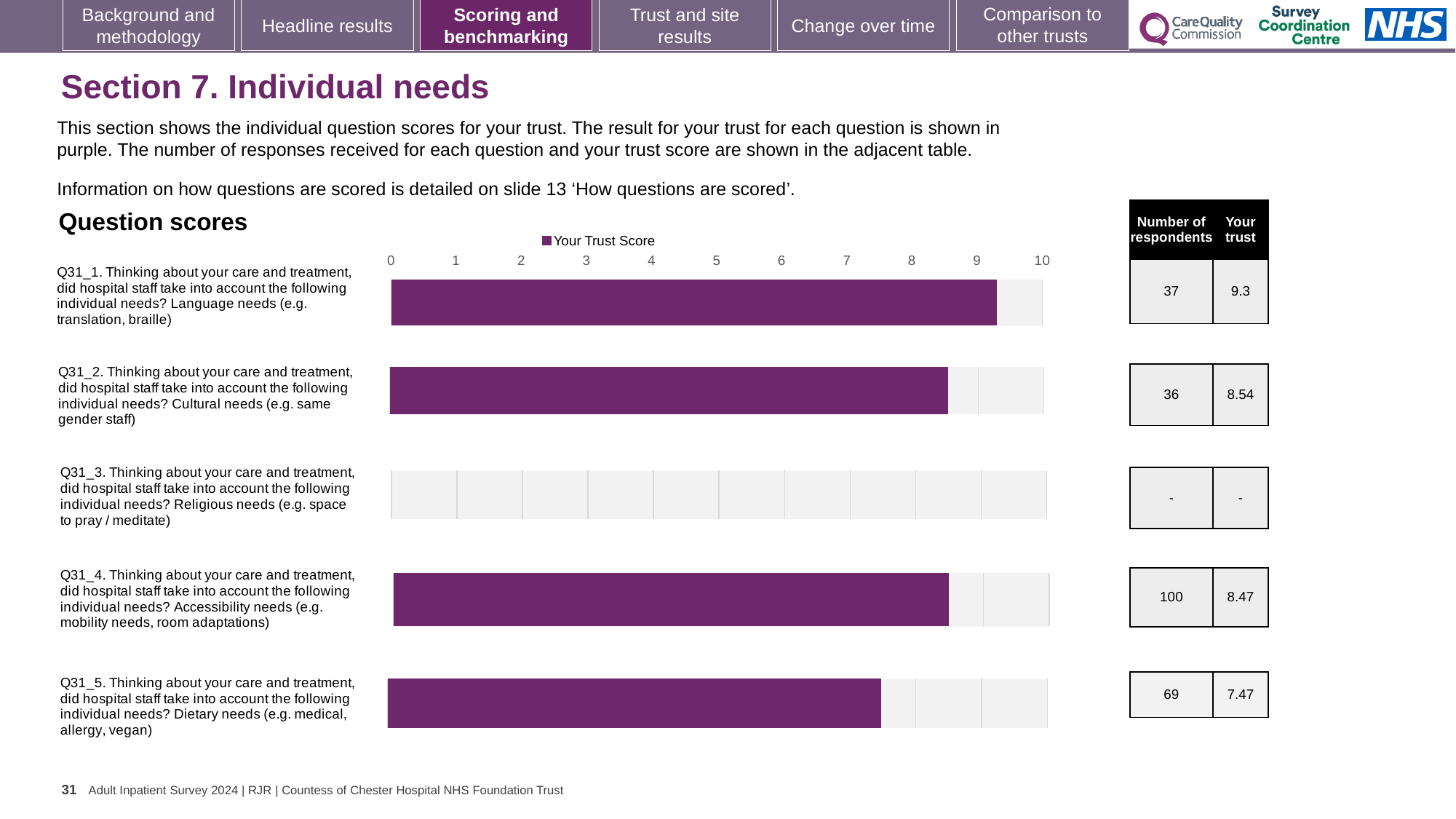
How many respondents answered Q31_4 (Accessibility needs)? 100 How many questions are listed in the Question scores chart? 5 What kind of chart is used to show the question scores? bar chart Which has the larger trust score, Q31_2 (Cultural needs) or Q31_5 (Dietary needs)? Q31_2 (Cultural needs) Which question has the highest trust score? Q31_1 (Language needs) What is the difference between the trust scores for Q31_1 (Language needs) and Q31_5 (Dietary needs)? 1.83 Which question with a plotted bar has the lowest trust score? Q31_5 (Dietary needs) How many series does the chart legend list? 1 What is the trust score for Q31_1 (Language needs)? 9.3 What is the trust score for Q31_5 (Dietary needs)? 7.47 Is the trust score for Q31_5 (Dietary needs) greater or less than 8? less What is the trust score for Q31_4 (Accessibility needs)? 8.47